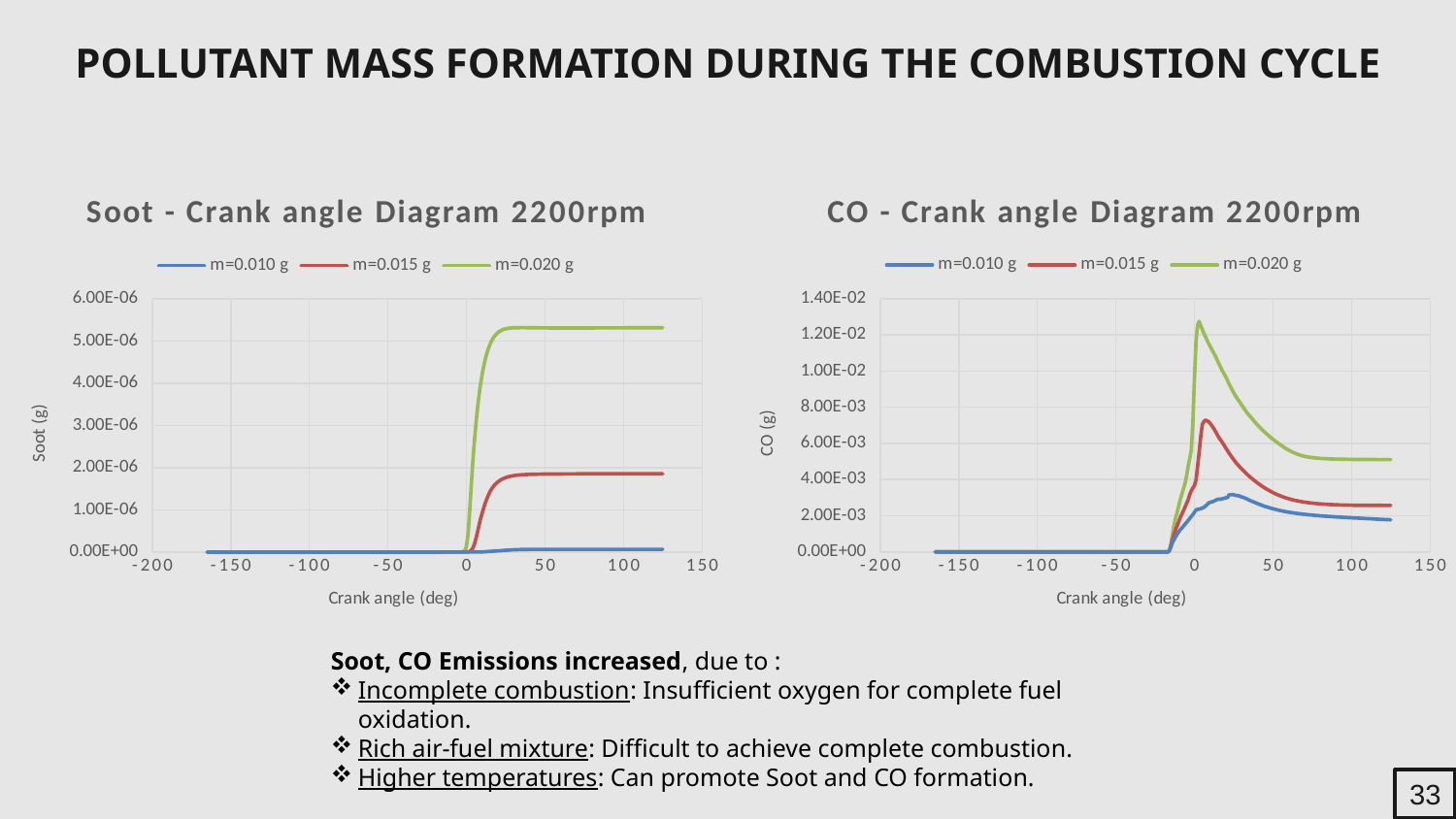
What is the y-axis title of the "CO - Crank angle Diagram 2200rpm" chart? CO (g) In the "CO - Crank angle Diagram 2200rpm" chart, after reaching its peak near 0 degrees, does the CO value for m=0.020 g rise or fall as crank angle increases? fall In the "CO - Crank angle Diagram 2200rpm" chart, which series has the lowest peak CO value? m=0.010 g In the "Soot - Crank angle Diagram 2200rpm" chart, is the final soot value for m=0.020 g greater or less than 4.00E-06? greater What kind of chart is the "Soot - Crank angle Diagram 2200rpm" chart? line chart In the "CO - Crank angle Diagram 2200rpm" chart, is the peak CO value for m=0.020 g greater or less than 1.00E-02? greater In the "Soot - Crank angle Diagram 2200rpm" chart, is the final soot value for m=0.015 g greater or less than 1.00E-06? greater What is the x-axis title of the "Soot - Crank angle Diagram 2200rpm" chart? Crank angle (deg) In the "Soot - Crank angle Diagram 2200rpm" chart, which series reaches the highest soot value? m=0.020 g In the "CO - Crank angle Diagram 2200rpm" chart, which series has a higher peak CO value, m=0.015 g or m=0.010 g? m=0.015 g How many series does the legend of the "CO - Crank angle Diagram 2200rpm" chart list? 3